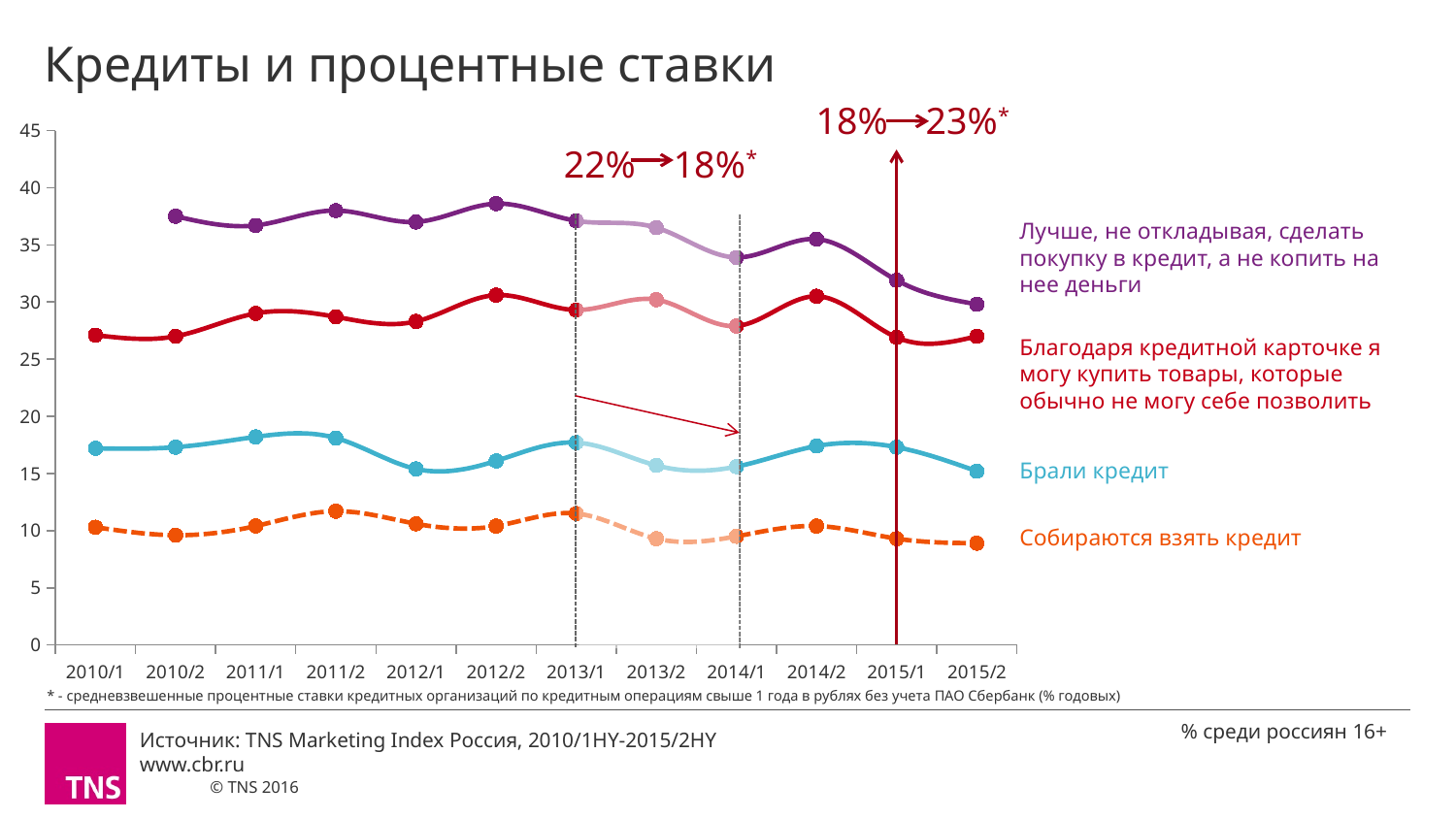
How many series are plotted on the chart? 4 Is the value for "Благодаря кредитной карточке я могу купить товары, которые обычно не могу себе позволить" in 2015/1 greater or less than 25? greater Is the value for "Собираются взять кредит" in 2013/2 greater or less than 10? less Is the value for "Лучше, не откладывая, сделать покупку в кредит, а не копить на нее деньги" in 2015/2 greater or less than 35? less Which is larger for "Благодаря кредитной карточке я могу купить товары, которые обычно не могу себе позволить": the value in 2010/1 or in 2012/2? 2012/2 Which series has the lowest values across the whole chart? Собираются взять кредит What kind of chart is shown on the slide? line chart Which series has the highest values across the whole chart? Лучше, не откладывая, сделать покупку в кредит, а не копить на нее деньги How many time periods are shown on the x axis? 12 Does the "Лучше, не откладывая, сделать покупку в кредит, а не копить на нее деньги" series rise or fall from 2013/1 to 2015/2? fall